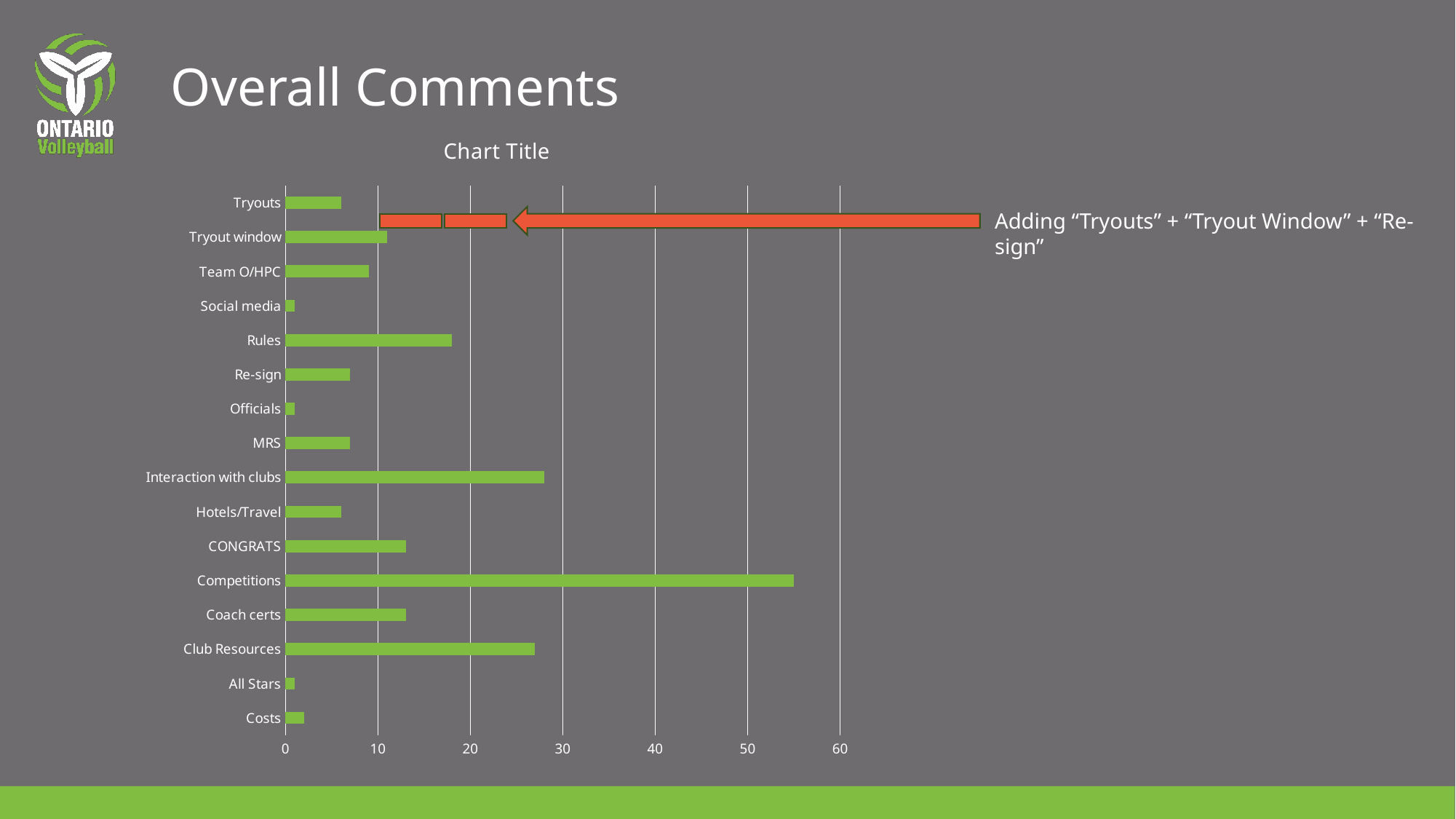
Is the value for Club Resources greater or less than 20? greater Is the value for Rules greater or less than 10? greater Which is larger, the value for Competitions or the value for Interaction with clubs? Competitions Is the value for Competitions greater or less than 50? greater How many categories are plotted in the chart? 16 Which category has the highest value in the chart? Competitions What is the title shown above the chart? Chart Title What kind of chart is shown on the slide? bar chart Which is larger, the value for Rules or the value for Tryouts? Rules